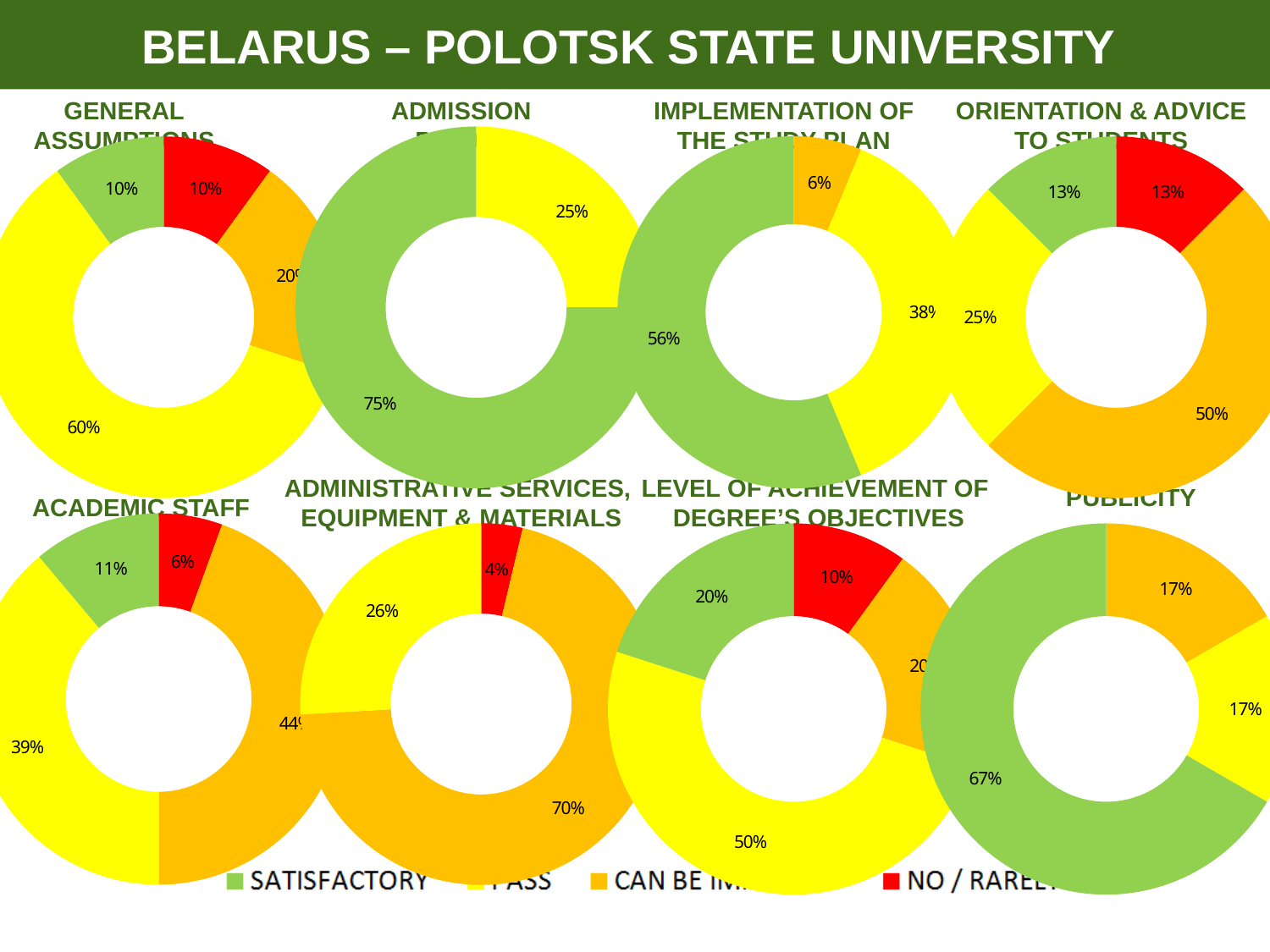
In the Implementation of the Study Plan chart, what percentage is shown for the green (Satisfactory) slice? 56% In the Administrative Services, Equipment & Materials chart, which slice is the smallest? The red slice, 4% What kind of chart is used on this slide? Donut (pie) chart In the General Assumptions chart, what percentage is shown for the yellow slice? 60% In the Academic Staff chart, what percentage is shown for the yellow slice? 39% In the Publicity chart, what percentage is shown for the green (Satisfactory) slice? 67% How many categories does the legend at the bottom of the slide list? 4 How many donut charts are shown on the slide? 8 In the Admission chart, which slice is the largest? The green (Satisfactory) slice, 75% In the Orientation & Advice to Students chart, what percentage is shown for the orange slice? 50% In the Admission chart, what is the difference between the green slice (75%) and the yellow slice (25%)? 50 percentage points Which chart has the larger green (Satisfactory) slice: Publicity or Implementation of the Study Plan? Publicity